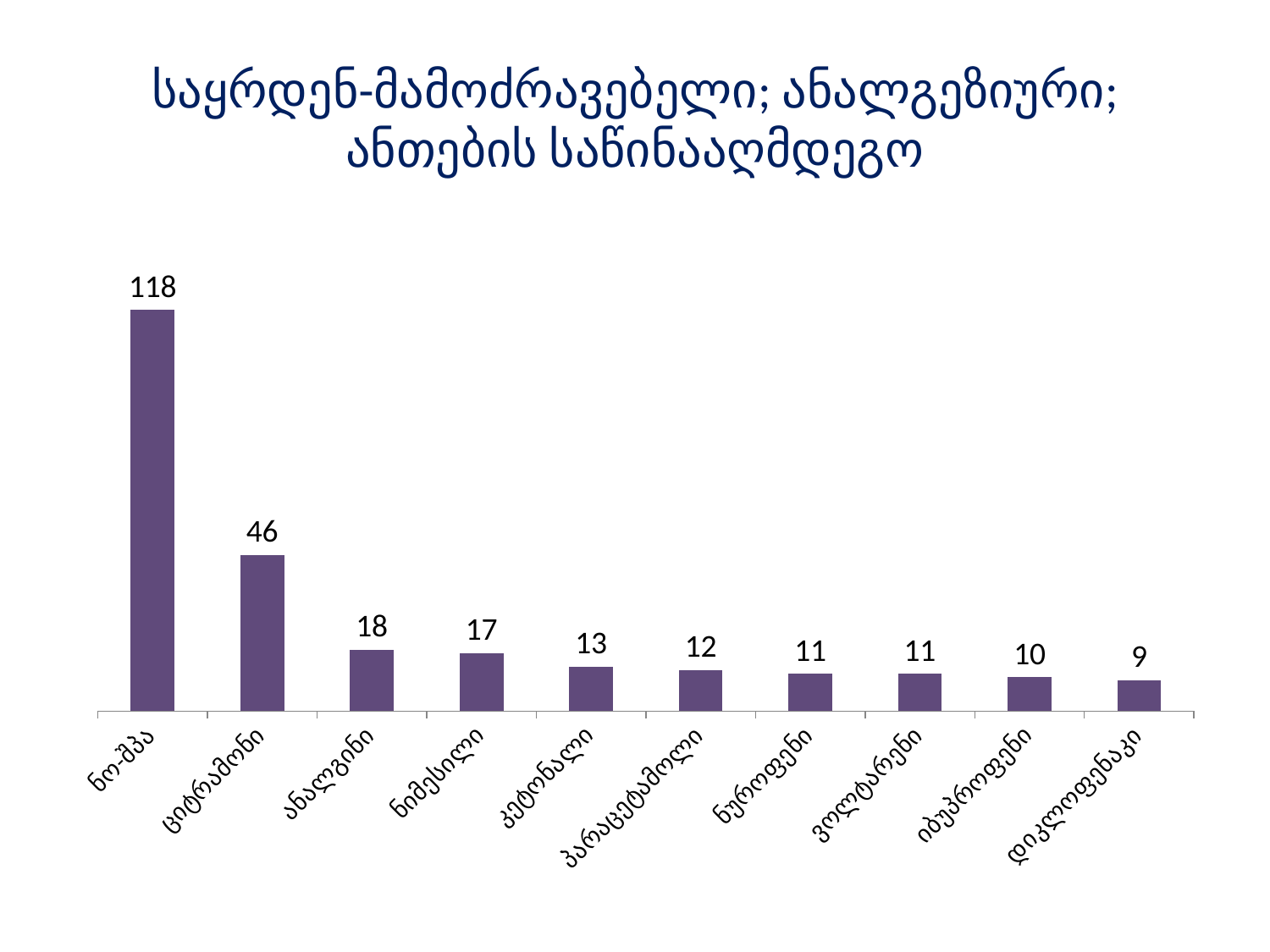
What kind of chart is shown on the slide? Bar chart How many categories are shown on the chart? 10 Which category has the highest value? ნო-შპა What is the difference between the values for პარაცეტამოლი and დიკლოფენაკი? 3 What is the value for იბუპროფენი? 10 What is the value for ნიმესილი? 17 Which category has the lowest value? დიკლოფენაკი What is the value for ციტრამონი? 46 What is the difference between the values for ნო-შპა and ციტრამონი? 72 Which is larger, the value for ანალგინი or the value for კეტონალი? ანალგინი What is the value for ნო-შპა? 118 Do the values rise or fall from left to right along the x axis? Fall